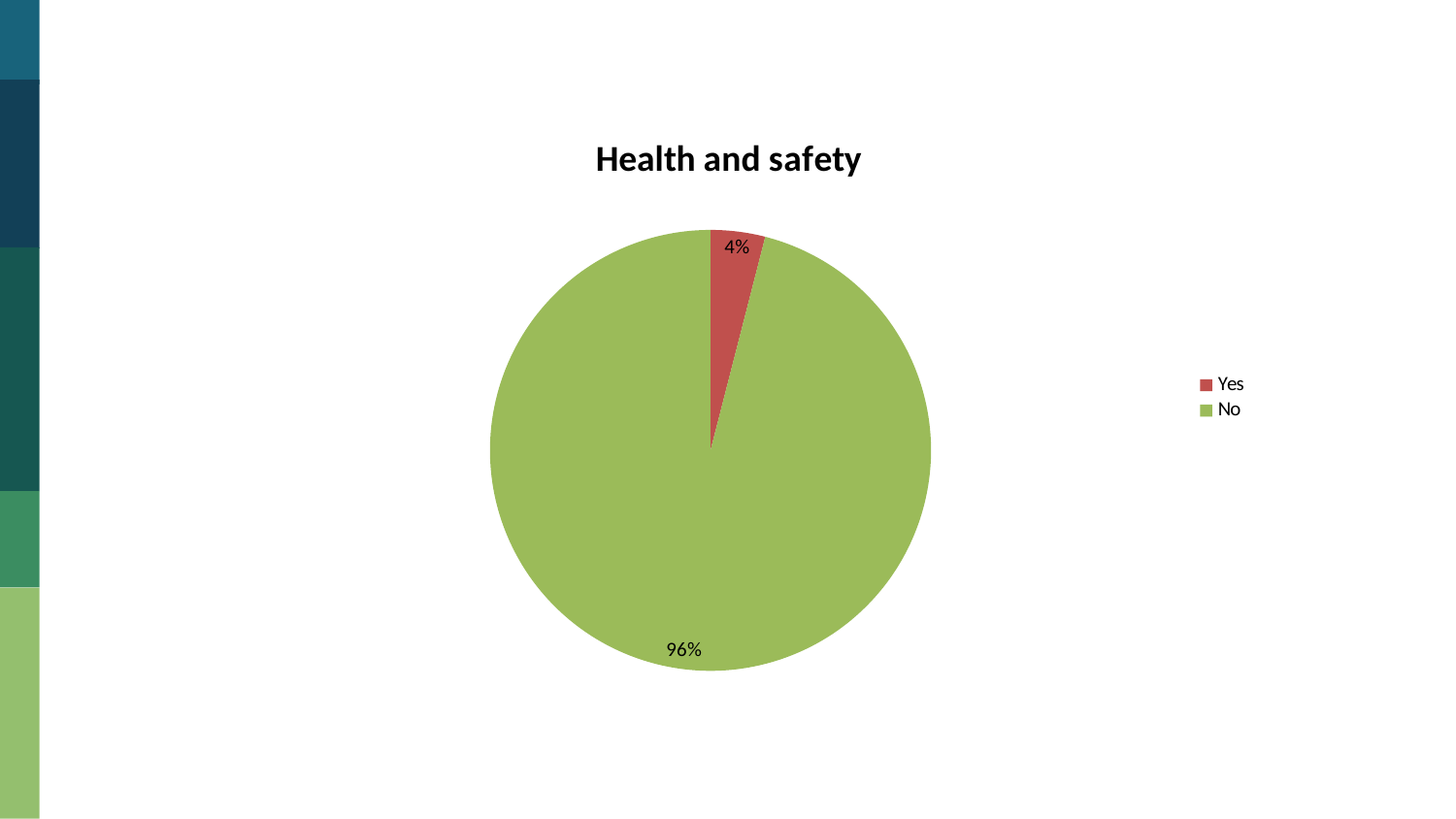
What is the title of the chart? Health and safety What percentage of the pie is labelled "No"? 96% Which category has the largest share of the pie? No How many categories does the legend list? 2 What percentage of the pie is labelled "Yes"? 4% What type of chart is shown on the slide? pie chart Which category has the smallest share of the pie? Yes What colour is the "Yes" slice? red What share of the pie does the "No" slice represent? 96% Which is larger, the "Yes" slice or the "No" slice? No What is the difference in percentage points between the "No" and "Yes" slices? 92